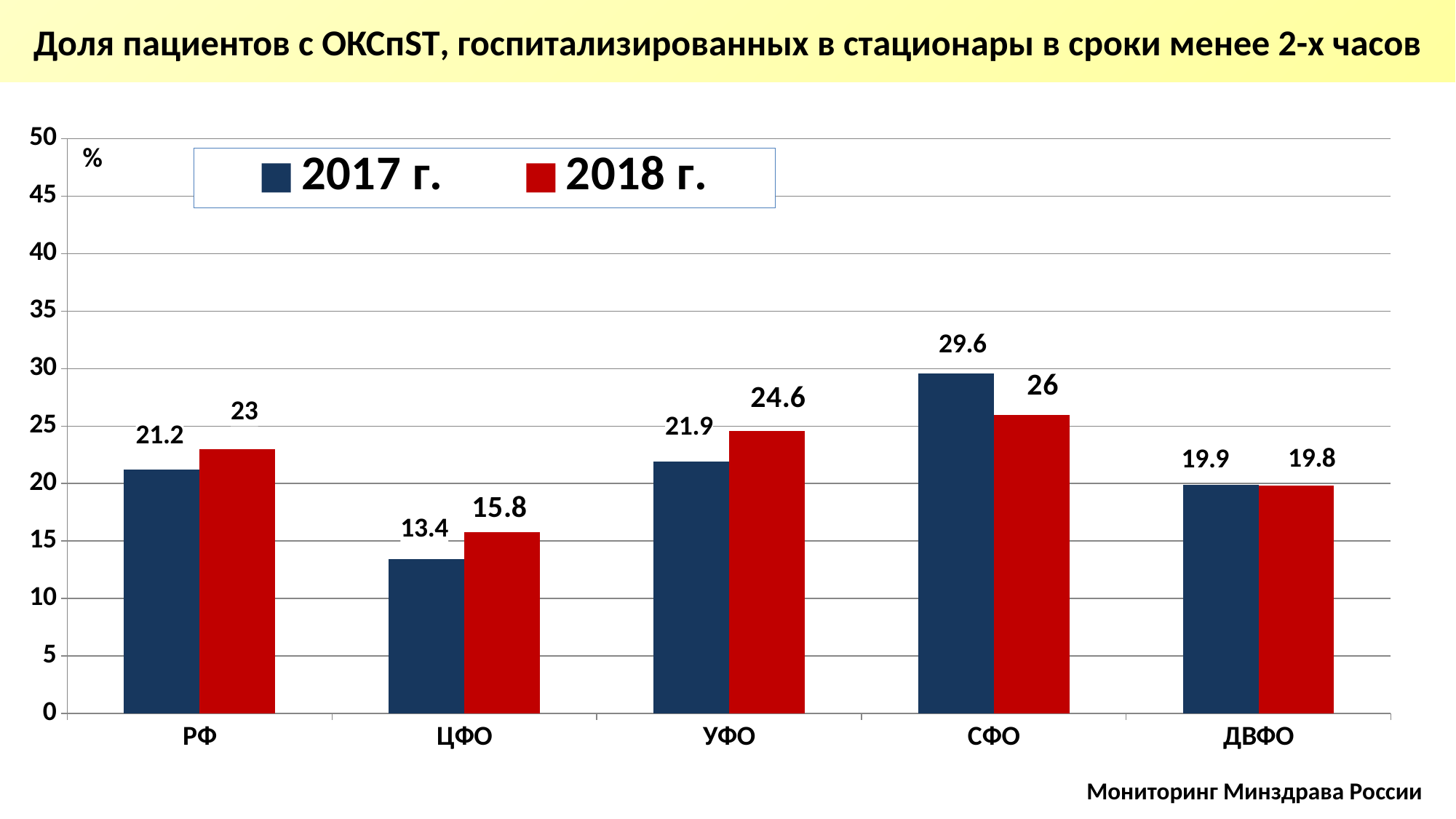
What is the value for ЦФО in 2018 г.? 15.8 Is the value for ЦФО in 2017 г. greater or less than 15? less What kind of chart is shown on the slide? bar chart Which category has the highest value in 2018 г.? СФО Which category has the lowest value in 2017 г.? ЦФО Which is larger for СФО: the 2017 г. value or the 2018 г. value? 2017 г. Which colour represents 2018 г. in the legend? red How many categories are shown on the x axis? 5 What is the value for РФ in 2018 г.? 23 What is the difference between the 2018 г. and 2017 г. values for УФО? 2.7 What is the value for СФО in 2017 г.? 29.6 How many series does the legend list? 2